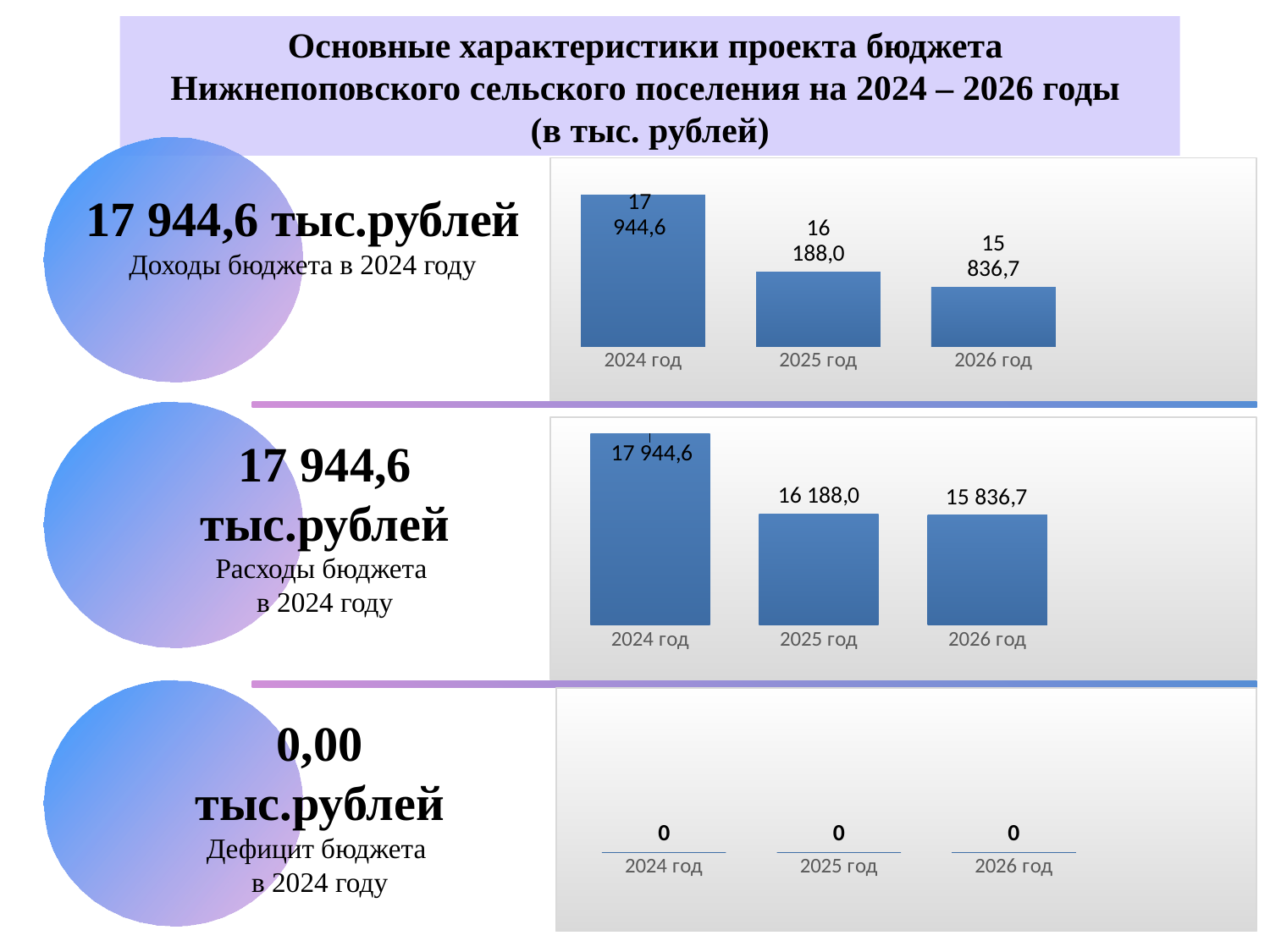
In the top chart, do the values rise or fall from 2024 год to 2026 год? fall In the middle chart, what is the value for 2025 год? 16 188,0 How many categories does the top chart show? 3 In the top chart, which year has the highest value? 2024 год In the top chart, what is the difference between the values for 2024 год and 2025 год? 1 756,6 In the middle chart, which is larger, the value for 2024 год or the value for 2026 год? 2024 год In the middle chart, what is the difference between the values for 2025 год and 2026 год? 351,3 In the middle chart, which year has the lowest value? 2026 год In the top chart, what is the value for 2026 год? 15 836,7 In the bottom chart, what is the value for 2025 год? 0 In the top chart, what is the value for 2024 год? 17 944,6 What kind of chart is the middle chart? bar chart